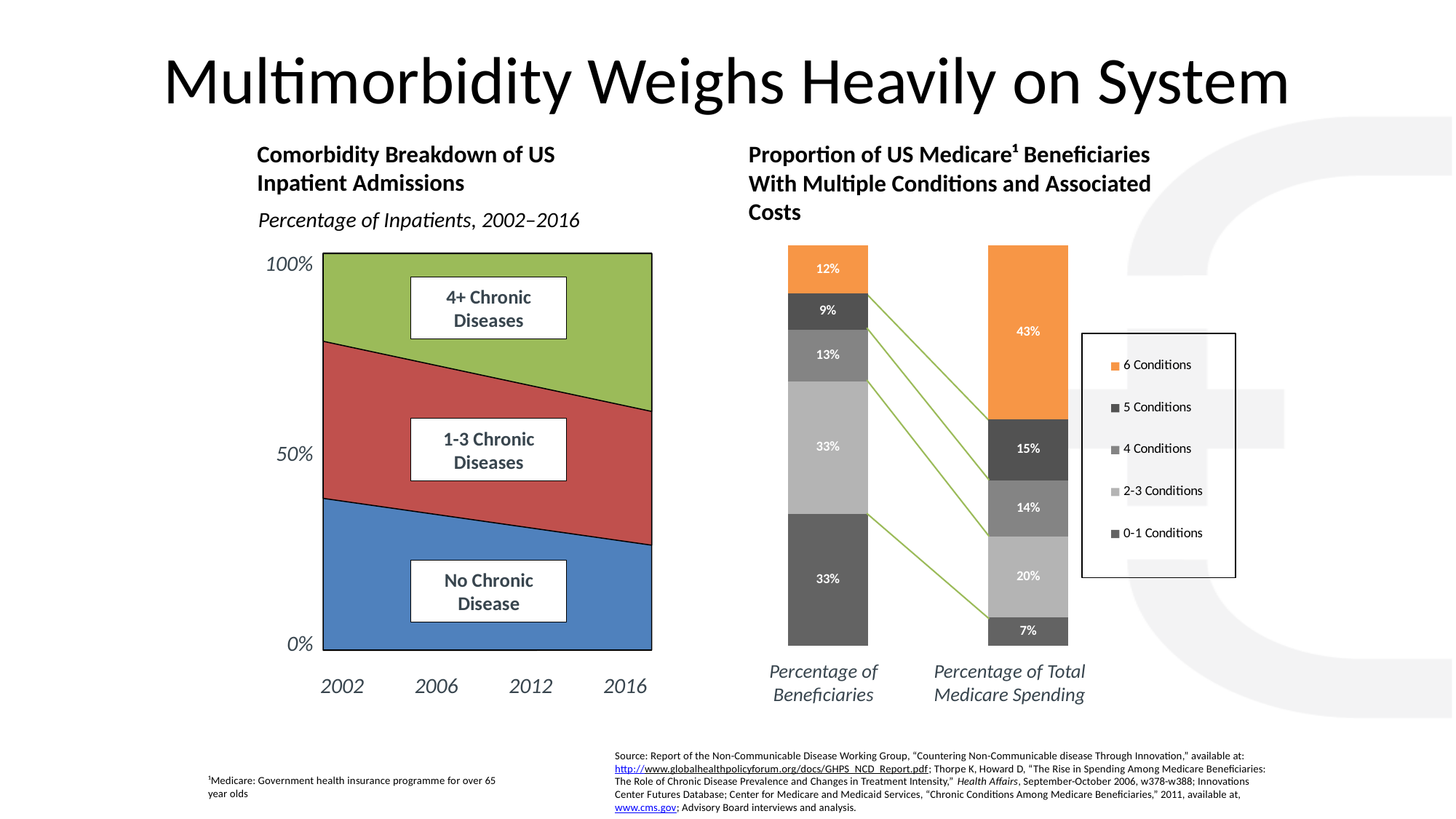
In the 'Proportion of US Medicare Beneficiaries' chart, which condition group accounts for the largest share of total Medicare spending? 6 Conditions What kind of chart is the 'Proportion of US Medicare Beneficiaries With Multiple Conditions and Associated Costs' chart? Stacked bar chart How many years are labelled on the x axis of the 'Comorbidity Breakdown of US Inpatient Admissions' chart? 4 In the 'Proportion of US Medicare Beneficiaries' chart, is the 2-3 Conditions share larger for Percentage of Beneficiaries or Percentage of Total Medicare Spending? Percentage of Beneficiaries In the 'Proportion of US Medicare Beneficiaries' chart, what percentage of total Medicare spending is attributed to beneficiaries with 0-1 Conditions? 7% In the 'Proportion of US Medicare Beneficiaries' chart, which condition group accounts for the smallest share of total Medicare spending? 0-1 Conditions In the 'Proportion of US Medicare Beneficiaries' chart, what is the difference between the 6 Conditions share of total Medicare spending and its share of beneficiaries? 31 percentage points In the 'Proportion of US Medicare Beneficiaries' chart, what percentage of total Medicare spending is attributed to beneficiaries with 6 Conditions? 43% In the 'Comorbidity Breakdown of US Inpatient Admissions' chart, does the share of inpatients with No Chronic Disease rise or fall from 2002 to 2016? Fall In the 'Proportion of US Medicare Beneficiaries' chart, what percentage of beneficiaries have 6 Conditions? 12% In the 'Comorbidity Breakdown of US Inpatient Admissions' chart, is the share of inpatients with No Chronic Disease in 2002 greater or less than 50%? less How many series does the legend of the 'Proportion of US Medicare Beneficiaries' chart list? 5